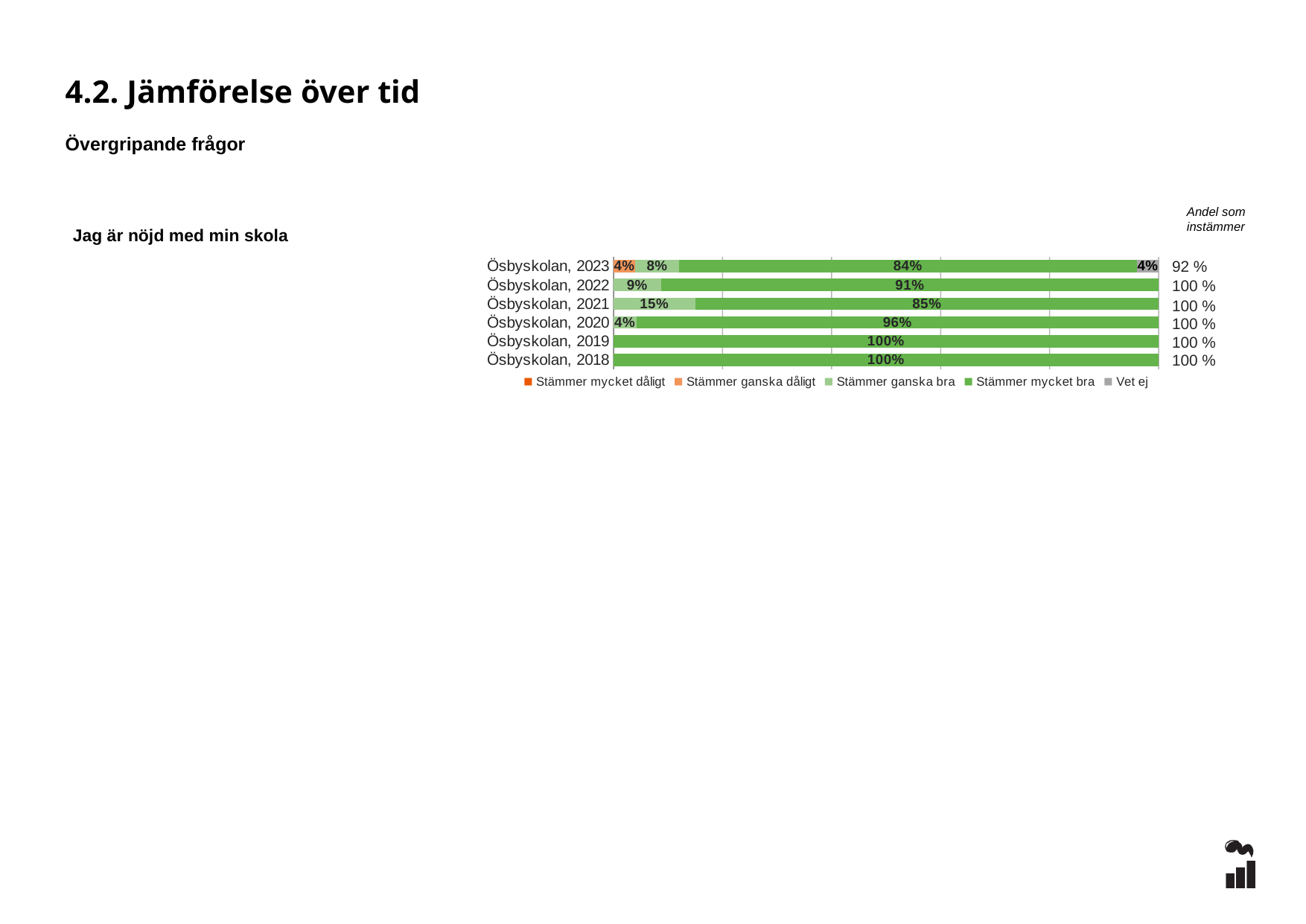
What is the value for 'Stämmer mycket bra' for Ösbyskolan, 2023? 84% How many series does the legend list? 5 What kind of chart is shown on the slide? stacked bar chart What is the title of the question shown next to the chart? Jag är nöjd med min skola What is the difference between the 'Stämmer mycket bra' values for Ösbyskolan, 2022 and Ösbyskolan, 2021? 6% What is the 'Andel som instämmer' value for Ösbyskolan, 2023? 92 % What is the value for 'Vet ej' for Ösbyskolan, 2023? 4% What is the value for 'Stämmer ganska bra' for Ösbyskolan, 2021? 15% What is the value for 'Stämmer mycket bra' for Ösbyskolan, 2020? 96% How many categories (bars) does the chart show? 6 Which category has the lowest 'Stämmer mycket bra' value? Ösbyskolan, 2023 Which is larger: the 'Stämmer ganska bra' value for Ösbyskolan, 2022 or for Ösbyskolan, 2021? Ösbyskolan, 2021